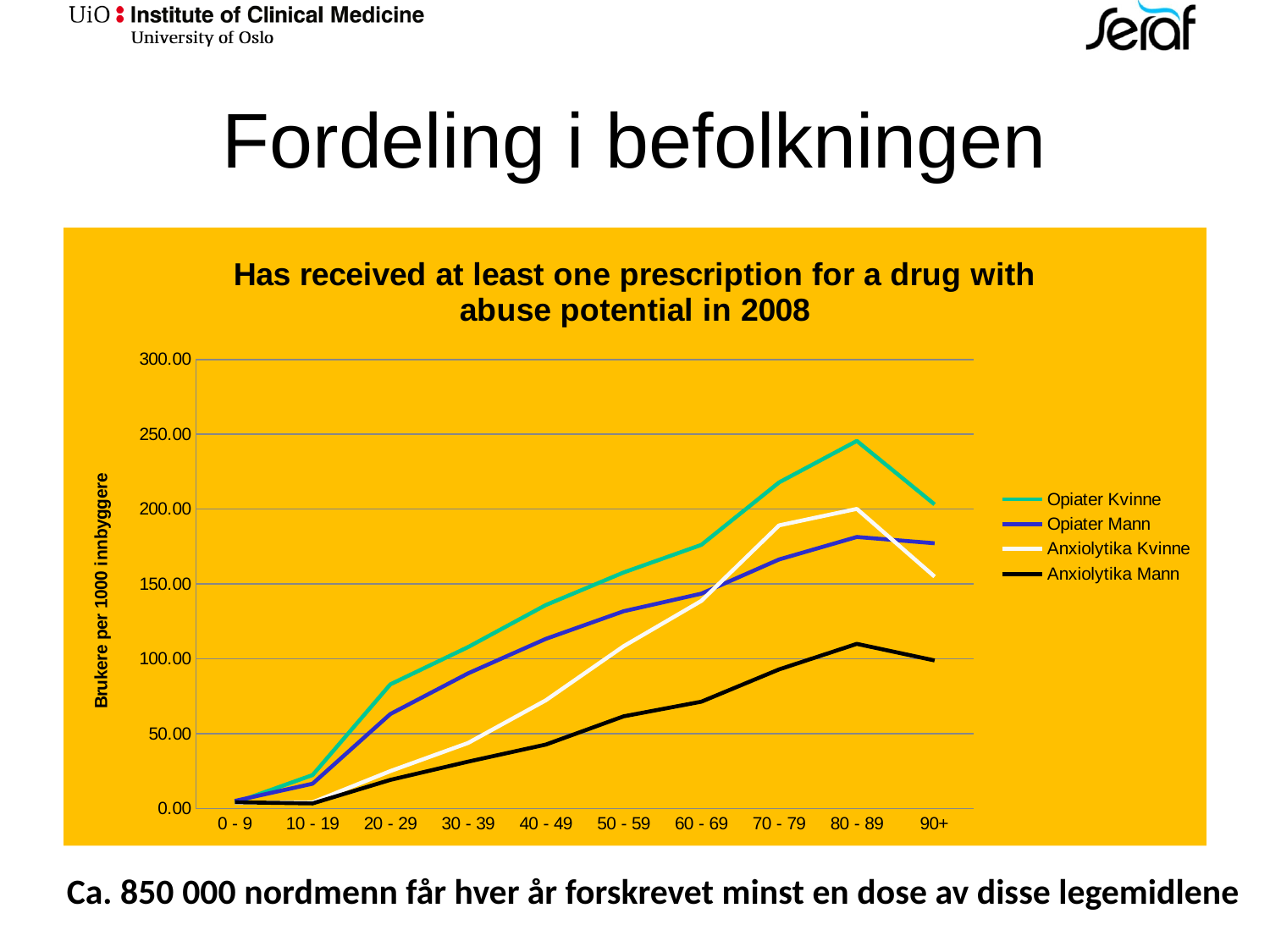
Does the Opiater Kvinne line rise or fall from the 0 - 9 age group to the 80 - 89 age group? Rise What is the title of the chart? Has received at least one prescription for a drug with abuse potential in 2008 For which age group does the Opiater Kvinne line reach its highest value? 80 - 89 Is the value for Opiater Kvinne in the 80 - 89 age group greater or less than 200? greater How many series does the legend list? 4 How many age groups are shown on the x axis? 10 Which is larger in the 60 - 69 age group, Opiater Kvinne or Anxiolytika Mann? Opiater Kvinne Is the value for Anxiolytika Mann in the 80 - 89 age group greater or less than 150? less What kind of chart is shown on the slide? Line chart Which series has the lowest value in the 80 - 89 age group? Anxiolytika Mann Is the value for Opiater Mann in the 80 - 89 age group greater or less than 200? less What is the label on the y axis of the chart? Brukere per 1000 innbyggere